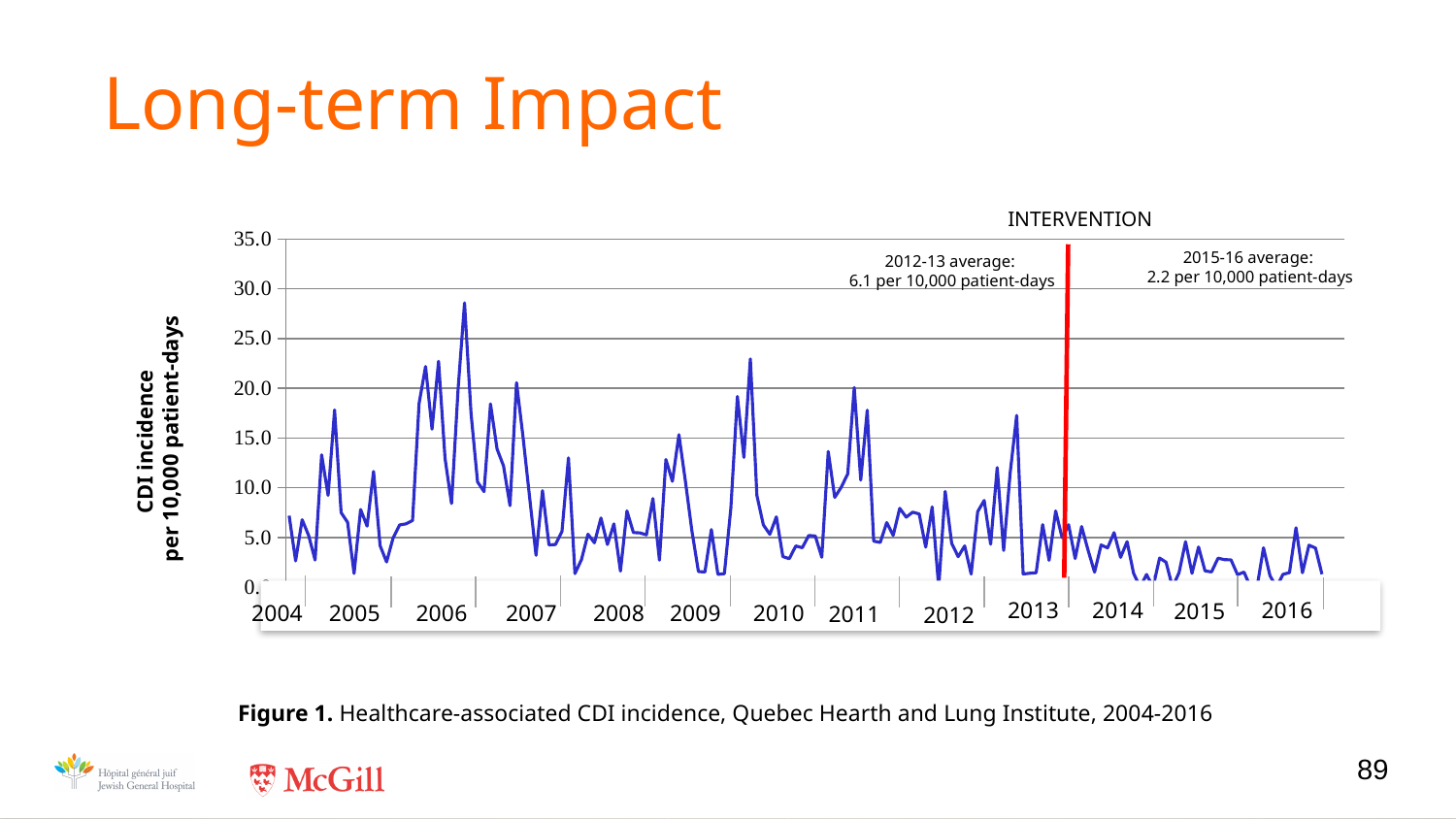
What is the label of the y axis? CDI incidence per 10,000 patient-days Is the highest peak of the line, in 2006, greater or less than 25.0? greater What is the 2012-13 average CDI incidence stated on the chart? 6.1 per 10,000 patient-days What is the 2015-16 average CDI incidence stated on the chart? 2.2 per 10,000 patient-days How many year labels are shown along the x axis? 13 What kind of chart is shown on the slide? line chart What does the red vertical line on the chart mark? INTERVENTION Are the values plotted after the intervention line (2014 onward) greater or less than 10.0? less In which year does the line reach its highest peak? 2006 Which is larger, the 2012-13 average or the 2015-16 average? 2012-13 average By how much does the 2012-13 average exceed the 2015-16 average, in cases per 10,000 patient-days? 3.9 How do the CDI incidence values change after the red intervention line compared with before it? they fall